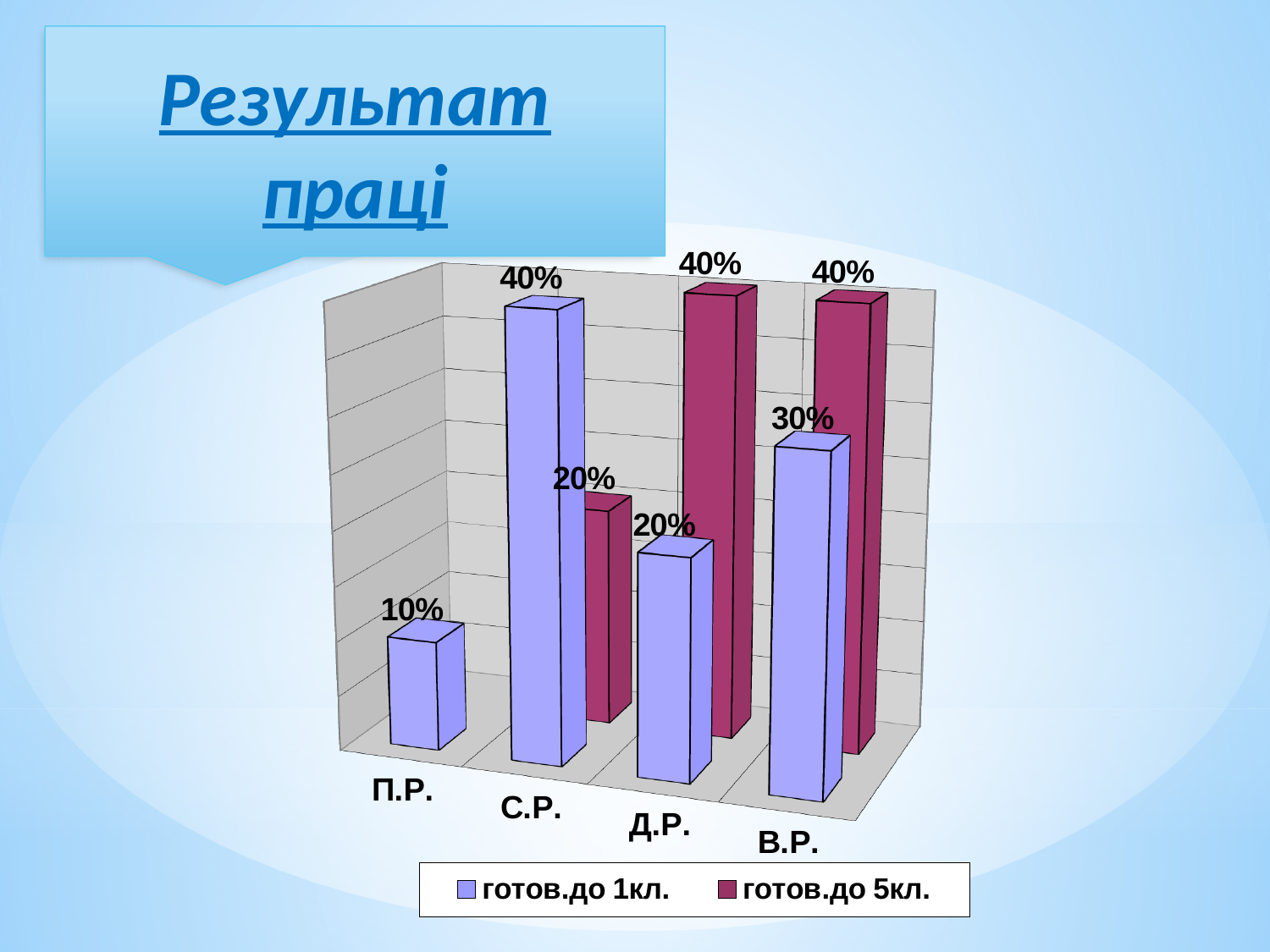
Which category has the highest value in the series готов.до 1кл.? С.Р. Which category has the lowest value in the series готов.до 1кл.? П.Р. For В.Р., which series has the larger value, готов.до 1кл. or готов.до 5кл.? готов.до 5кл. What is the value for С.Р. in the series готов.до 1кл.? 40% What is the difference between the готов.до 1кл. and готов.до 5кл. values for Д.Р.? 20% What is the value for С.Р. in the series готов.до 5кл.? 20% How many series does the legend list? 2 What is the value for В.Р. in the series готов.до 1кл.? 30% What is the value for Д.Р. in the series готов.до 5кл.? 40% How many categories are shown on the x axis? 4 What is the value for П.Р. in the series готов.до 1кл.? 10% What kind of chart is shown on the slide? bar chart